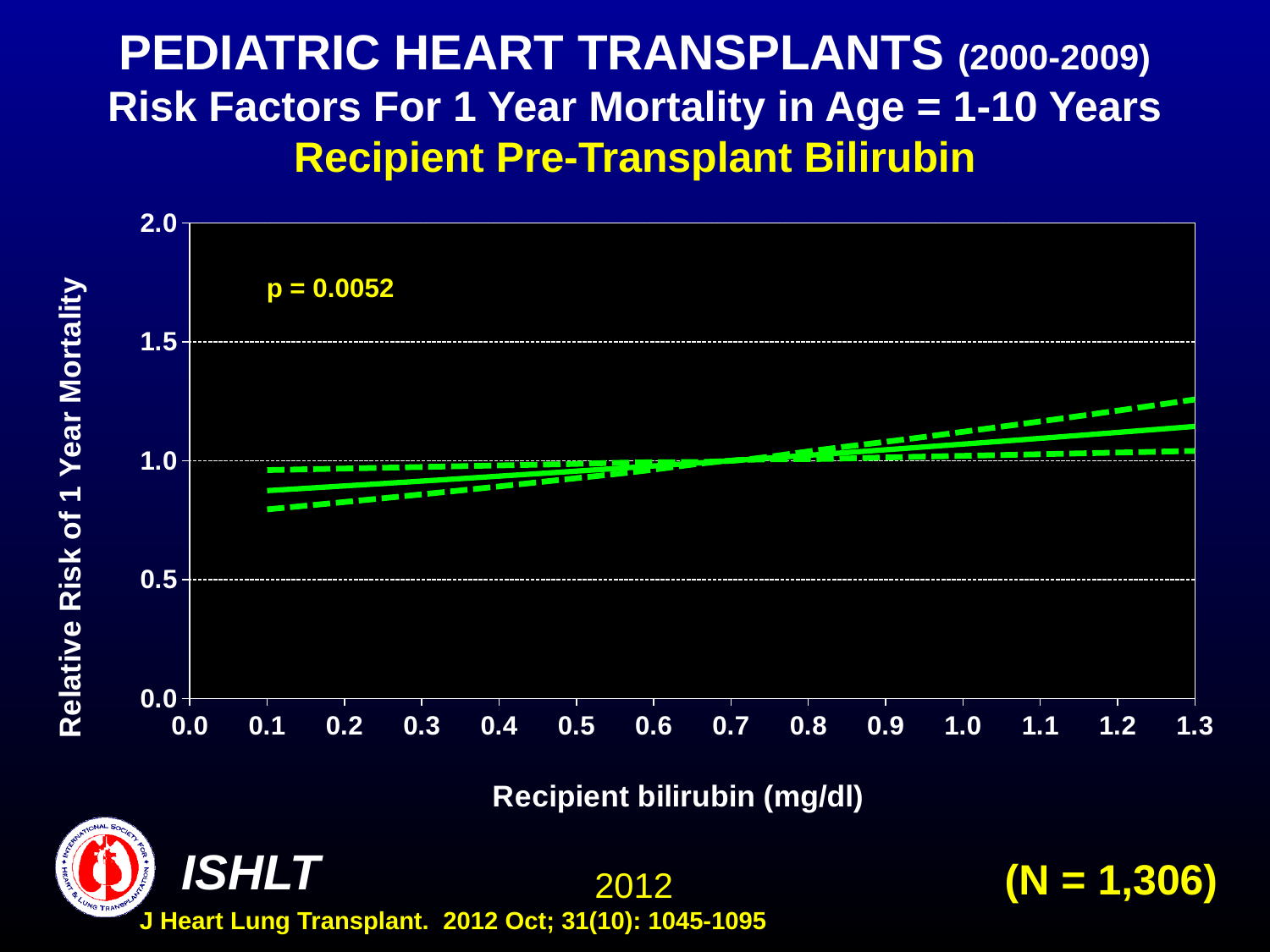
Is the relative risk of 1 year mortality at a recipient bilirubin of 0.1 mg/dl greater or less than 0.5? greater Is the relative risk of 1 year mortality at a recipient bilirubin of 1.3 mg/dl greater or less than 1.0? greater How many lines (solid and dashed) are plotted on the chart? 3 What p-value is printed on the chart? p = 0.0052 What kind of chart is shown on the slide? line chart Is the relative risk of 1 year mortality at a recipient bilirubin of 0.1 mg/dl greater or less than 1.0? less Does the relative risk of 1 year mortality rise or fall as recipient bilirubin increases along the x axis? rise What is the highest value shown on the x axis of the chart? 1.3 Which has the higher relative risk of 1 year mortality: a recipient bilirubin of 0.2 mg/dl or 1.2 mg/dl? 1.2 mg/dl What is the label of the x axis of the chart? Recipient bilirubin (mg/dl) What is the highest value shown on the y axis of the chart? 2.0